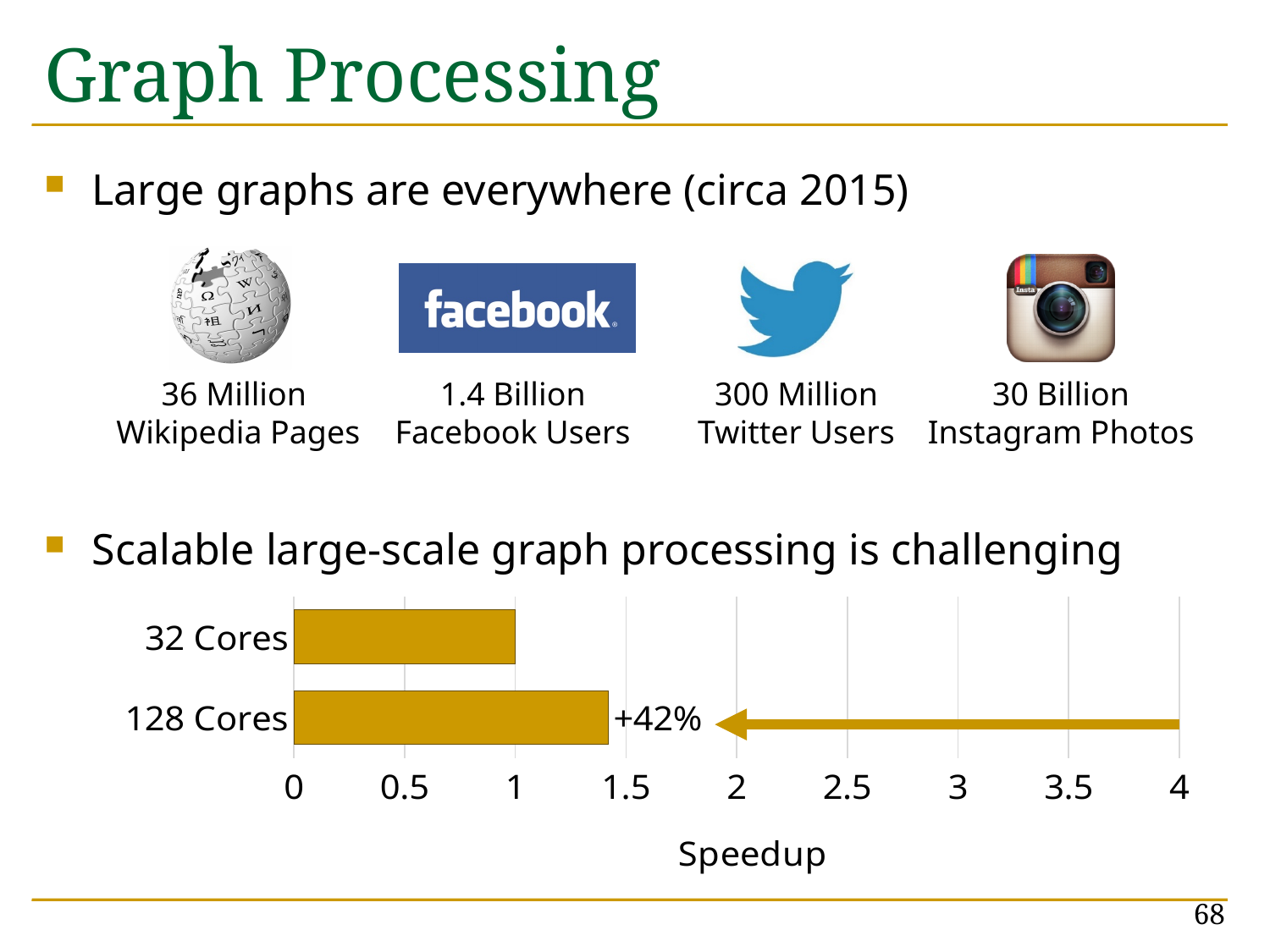
Is the speedup for 128 Cores greater or less than 1? greater What kind of chart is shown at the bottom of the slide? bar chart What annotation is printed next to the 128 Cores bar? +42% Is the speedup for 32 Cores greater or less than 0.5? greater How many categories are plotted in the Speedup chart? 2 Which category has the lowest speedup in the chart? 32 Cores Is the speedup for 128 Cores greater or less than 2? less Which has a larger speedup, 32 Cores or 128 Cores? 128 Cores Which category has the highest speedup in the chart? 128 Cores What is the title of the x axis in the chart? Speedup What is the speedup value for 32 Cores? 1